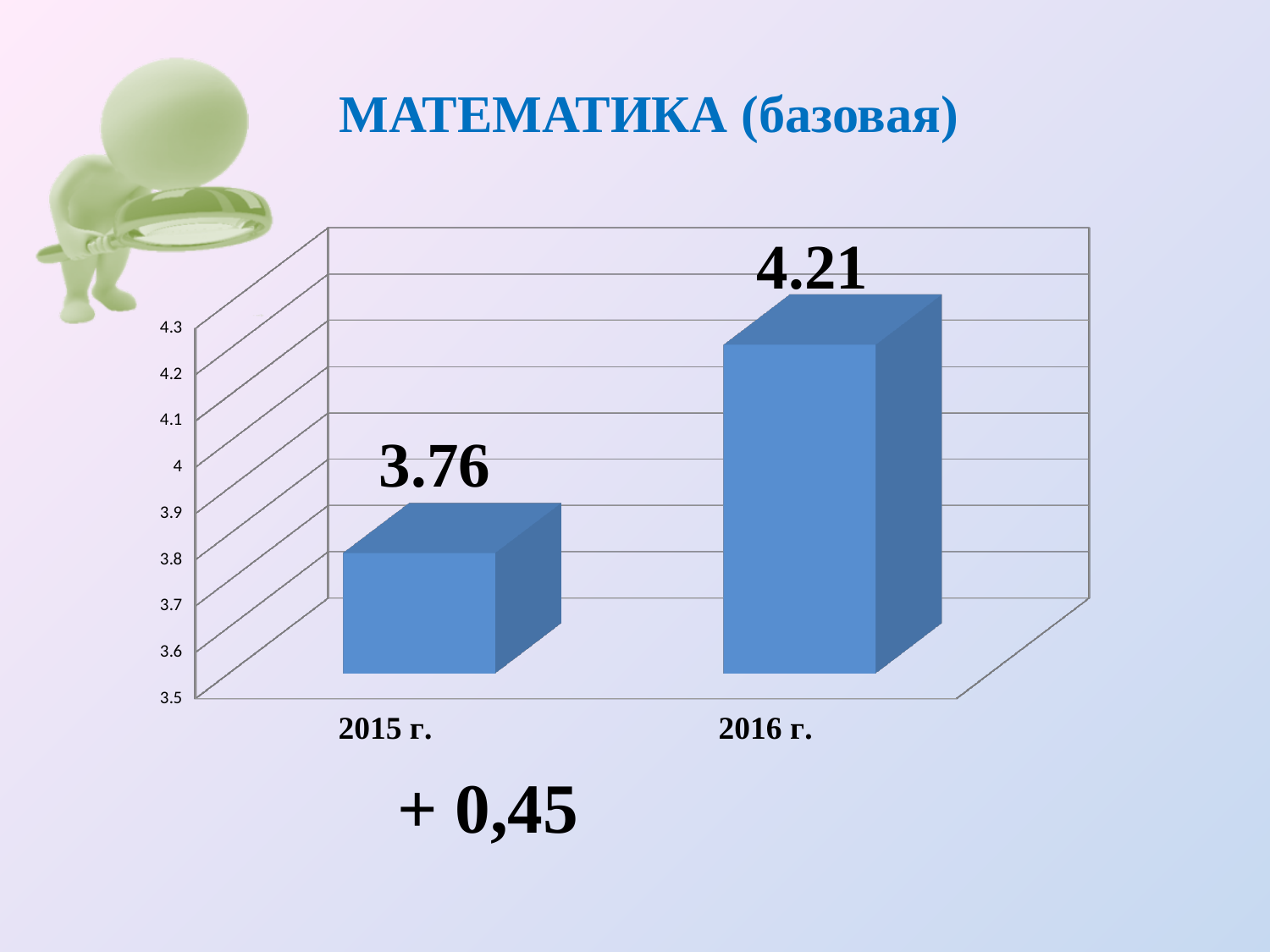
Which is larger, the value for 2015 г. or the value for 2016 г.? 2016 г. How many categories are shown on the x axis? 2 What kind of chart is shown on the slide? bar chart Which year has the lowest value? 2015 г. What is the title of the chart? МАТЕМАТИКА (базовая) Do the values rise or fall from 2015 г. to 2016 г.? rise Which year has the highest value? 2016 г. What is the value for 2016 г.? 4.21 Is the value for 2015 г. greater or less than 4? less What is the difference between the values for 2016 г. and 2015 г.? 0.45 Is the value for 2016 г. greater or less than 4.1? greater What is the value for 2015 г.? 3.76